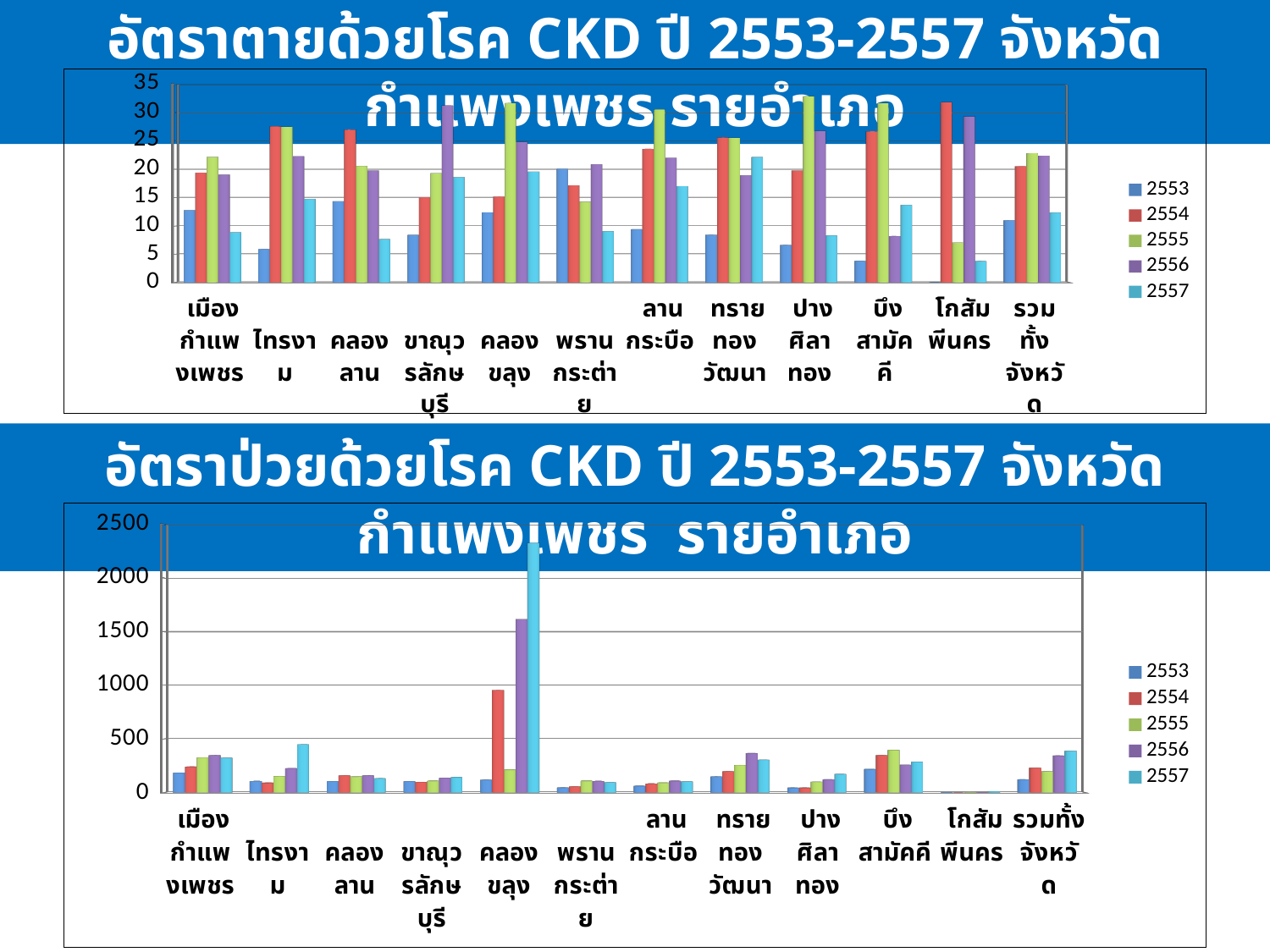
In the top chart (อัตราตายด้วยโรค CKD), which is larger for ไทรงาม: the 2554 value or the 2557 value? 2554 How many districts (categories) are shown on the x axis of the top chart (อัตราตายด้วยโรค CKD)? 12 In the top chart (อัตราตายด้วยโรค CKD), which district has the lowest 2553 value? โกสัมพีนคร In the top chart (อัตราตายด้วยโรค CKD), is the 2557 value for โกสัมพีนคร greater or less than 5? less In the bottom chart (อัตราป่วยด้วยโรค CKD), is the 2556 value for คลองขลุง greater or less than 1500? greater In the bottom chart (อัตราป่วยด้วยโรค CKD), which district has the tallest bar? คลองขลุง What kind of chart is the top chart (อัตราตายด้วยโรค CKD)? bar chart In the bottom chart (อัตราป่วยด้วยโรค CKD), which is larger for คลองขลุง: the 2556 value or the 2557 value? 2557 In the bottom chart (อัตราป่วยด้วยโรค CKD), is the 2557 value for คลองขลุง greater or less than 2000? greater What years do the legend entries of the top chart (อัตราตายด้วยโรค CKD) cover? 2553, 2554, 2555, 2556, 2557 How many series does the legend of the bottom chart (อัตราป่วยด้วยโรค CKD) list? 5